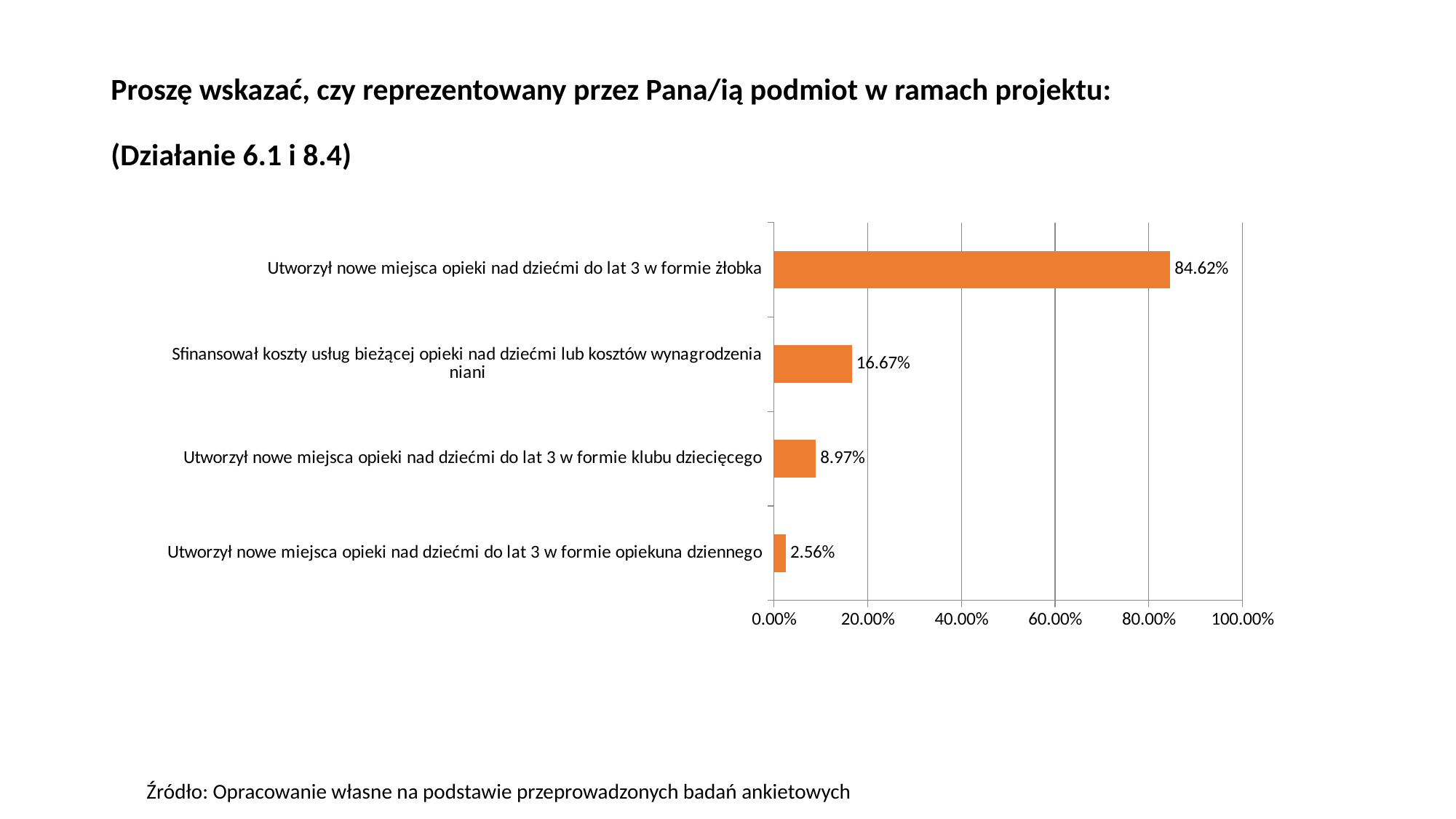
Which is larger: the value for 'Sfinansował koszty usług bieżącej opieki...' or the value for 'w formie klubu dziecięcego'? Sfinansował koszty usług bieżącej opieki nad dziećmi lub kosztów wynagrodzenia niani What kind of chart is shown on the slide? bar chart What percentage of respondents indicated 'Utworzył nowe miejsca opieki nad dziećmi do lat 3 w formie żłobka'? 84.62% What is the value for 'Utworzył nowe miejsca opieki nad dziećmi do lat 3 w formie klubu dziecięcego'? 8.97% Which category has the lowest value? Utworzył nowe miejsca opieki nad dziećmi do lat 3 w formie opiekuna dziennego What is the value for 'Utworzył nowe miejsca opieki nad dziećmi do lat 3 w formie opiekuna dziennego'? 2.56% What is the value shown for 'Sfinansował koszty usług bieżącej opieki nad dziećmi lub kosztów wynagrodzenia niani'? 16.67% Is the value for 'w formie żłobka' greater or less than 80.00%? greater What is the difference between the value for 'w formie żłobka' and the value for 'w formie klubu dziecięcego'? 75.65% Which category has the highest value? Utworzył nowe miejsca opieki nad dziećmi do lat 3 w formie żłobka What is the maximum value shown on the horizontal axis? 100.00% How many categories are shown in the chart? 4